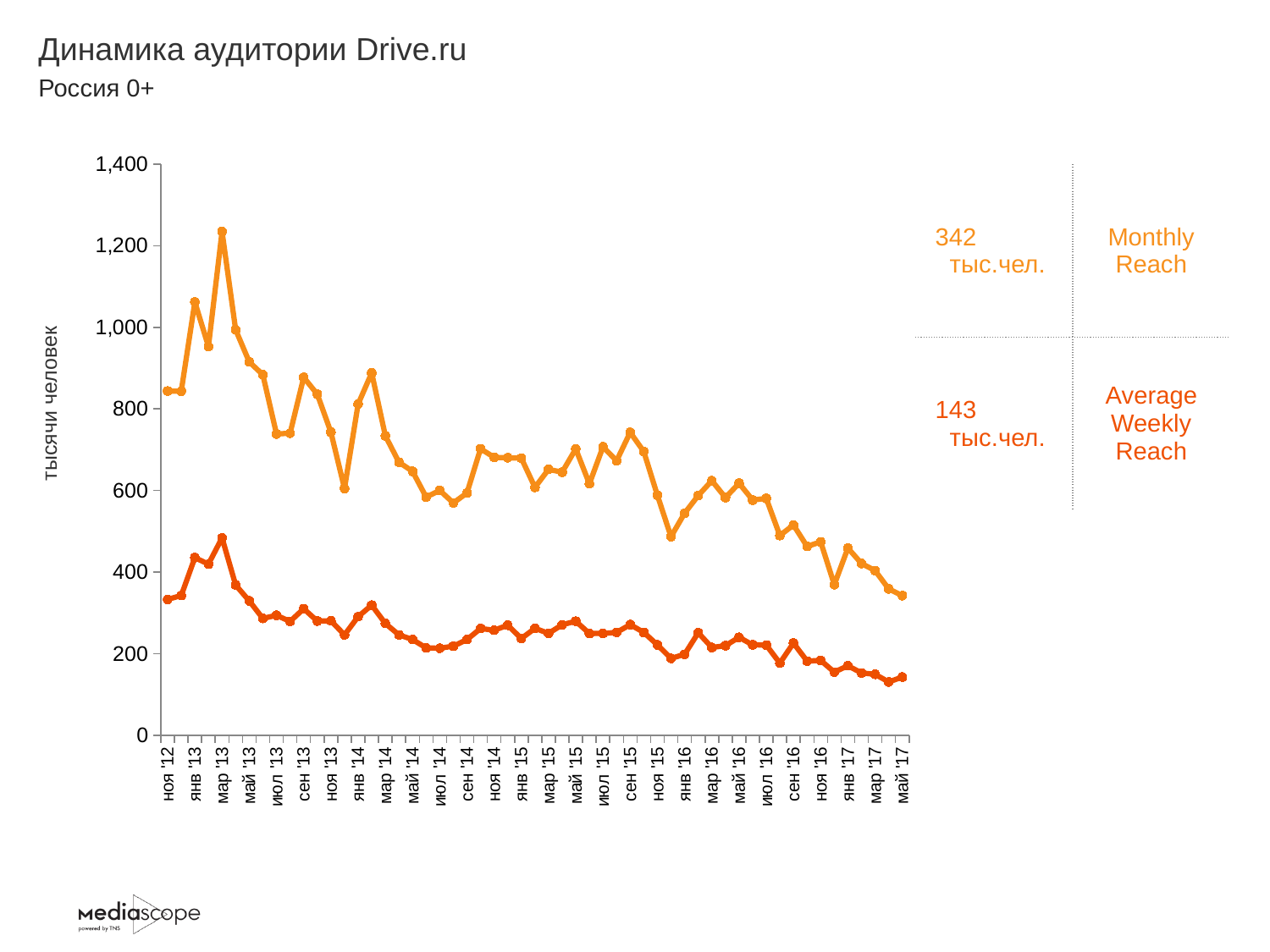
How many lines (series) are plotted on the chart? 2 Is the Average Weekly Reach value for мар '13 greater or less than 400? greater Is the Monthly Reach value for мар '13 greater or less than 1,000? greater What is the label on the vertical axis of the chart? тысячи человек In which month does the Average Weekly Reach line reach its highest point? мар '13 In which month does the Monthly Reach line reach its highest point? мар '13 Is the Monthly Reach value for май '17 greater or less than 400? less What kind of chart is shown on the slide? line chart What is the Monthly Reach value printed on the slide? 342 тыс.чел. Overall, does the Monthly Reach line rise or fall from ноя '12 to май '17? fall What is the Average Weekly Reach value printed on the slide? 143 тыс.чел. Which line is higher at сен '15, Monthly Reach or Average Weekly Reach? Monthly Reach